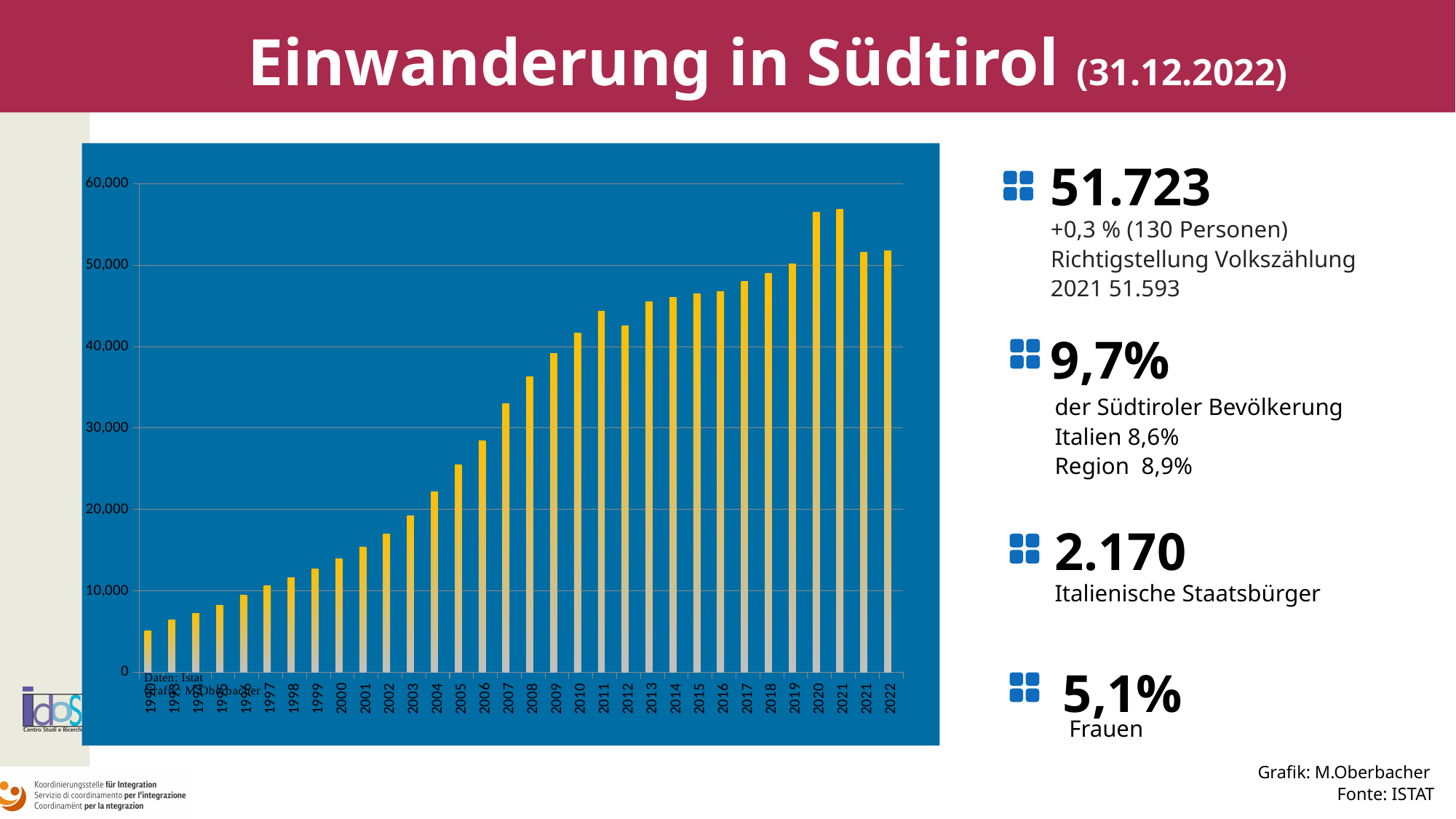
Which is larger, the value for 2011 or the value for 2012? 2011 Is the value for 2015 greater or less than 50,000? less Is the value for 2005 greater or less than 20,000? greater Is the value for 2008 greater or less than 40,000? less What kind of chart is shown on the slide? bar chart Which is larger, the value for 2020 or the value for 2022? 2020 What colour are the bars in the chart? yellow Do the values generally rise or fall from the earliest year to 2022? rise